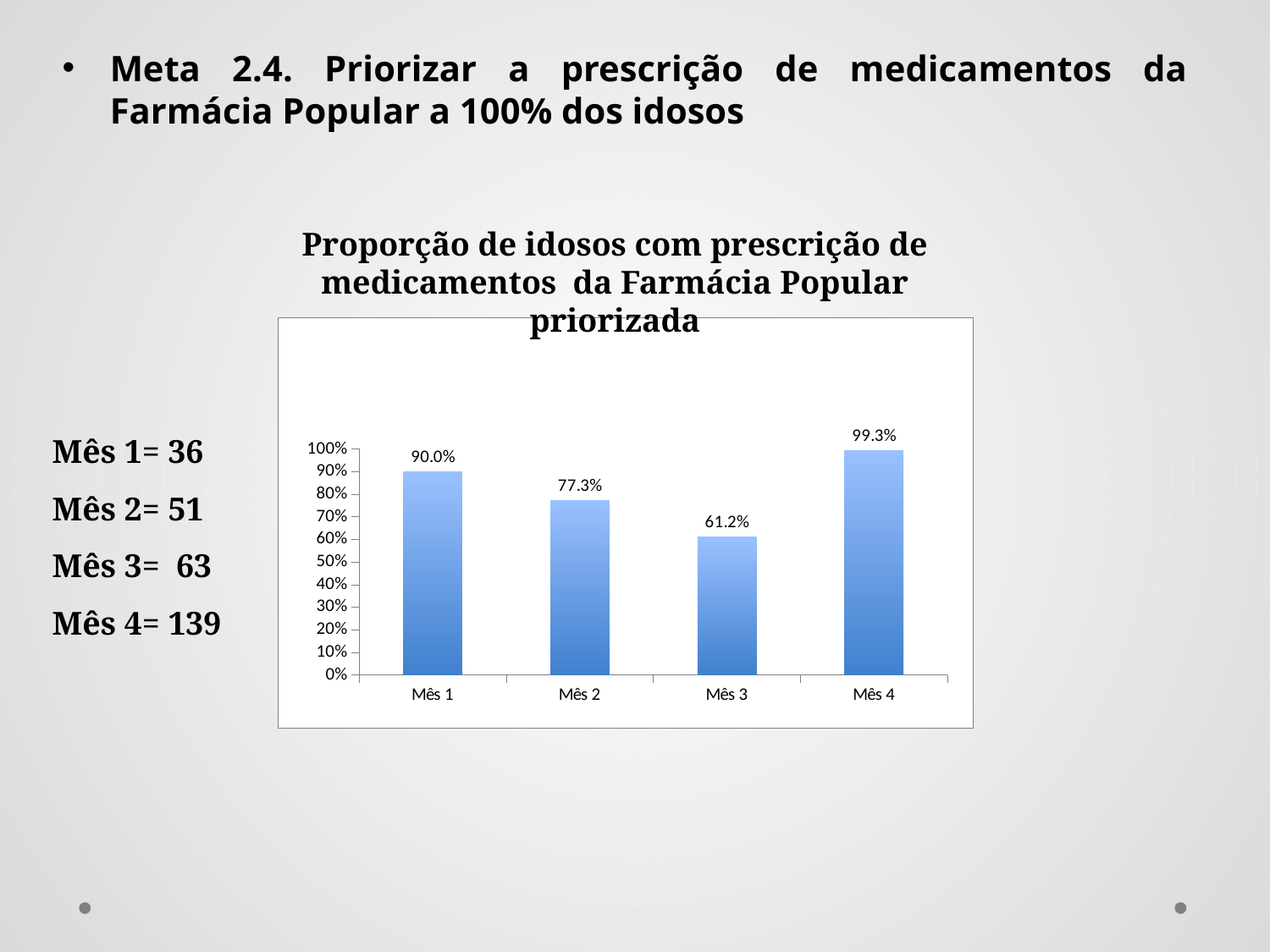
Which is larger, the value for Mês 2 or the value for Mês 3? Mês 2 Is the value for Mês 2 greater or less than 70%? greater What is the difference between the values for Mês 4 and Mês 3? 38.1% What is the value for Mês 1? 90.0% Which month has the highest value? Mês 4 What is the title of the chart? Proporção de idosos com prescrição de medicamentos da Farmácia Popular priorizada What is the value for Mês 4? 99.3% What kind of chart is shown on the slide? bar chart What is the difference between the values for Mês 1 and Mês 2? 12.7% Which month has the lowest value? Mês 3 What is the value for Mês 3? 61.2% How many months are shown on the chart? 4